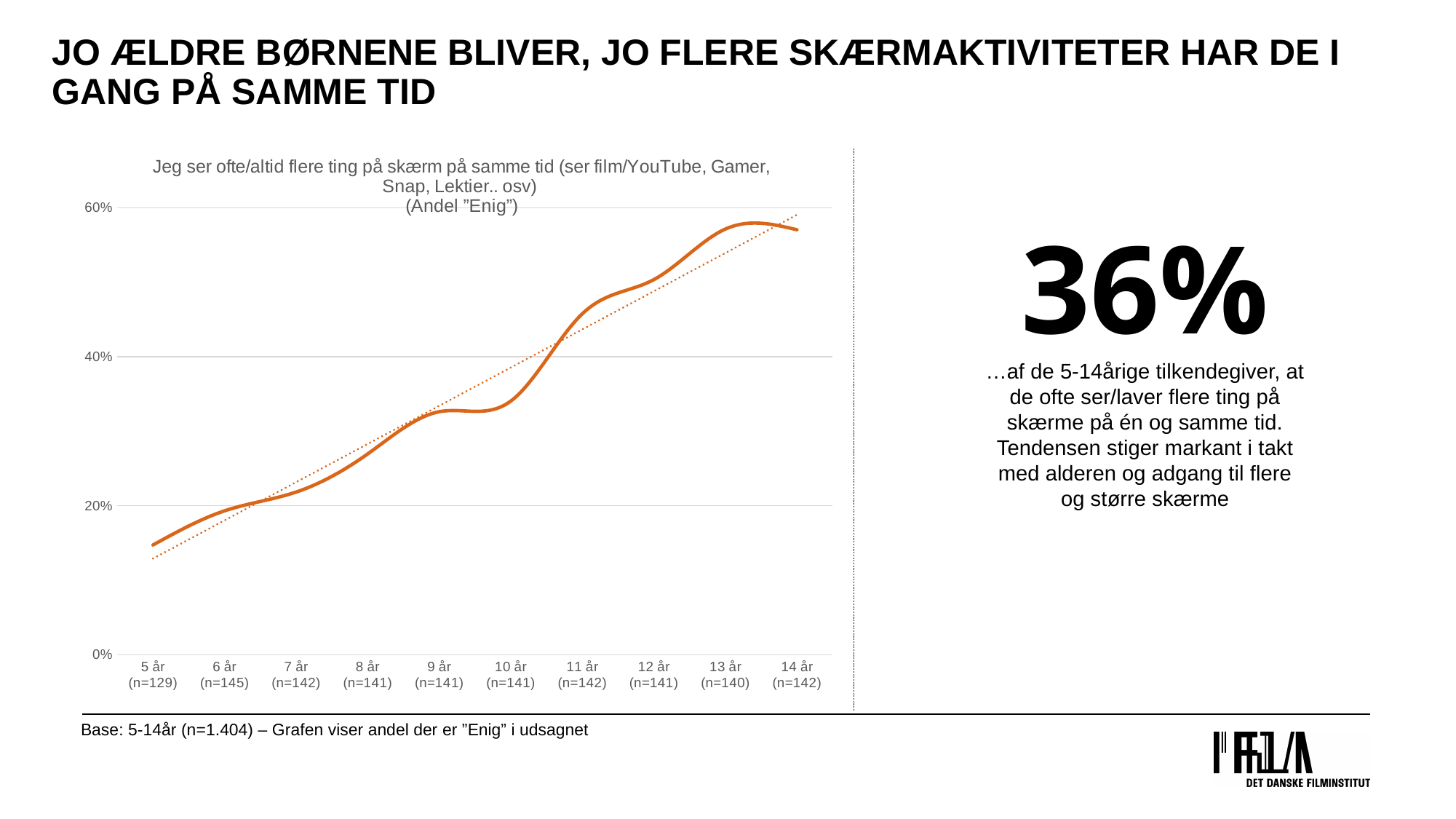
Is the value for 9 år greater or less than 20%? greater Is the value for 14 år greater or less than 40%? greater Is the value for 5 år greater or less than 20%? less Which has the larger value, 8 år or 12 år? 12 år How many age categories are plotted along the x axis of the chart? 10 Which age category has the lowest value in the chart? 5 år What is the highest percentage tick shown on the y axis of the chart? 60% What kind of chart is shown on the slide? line chart Do the values in the chart generally rise or fall as age increases from 5 år to 14 år? rise What is the sample size (n) shown for the 5 år category? n=129